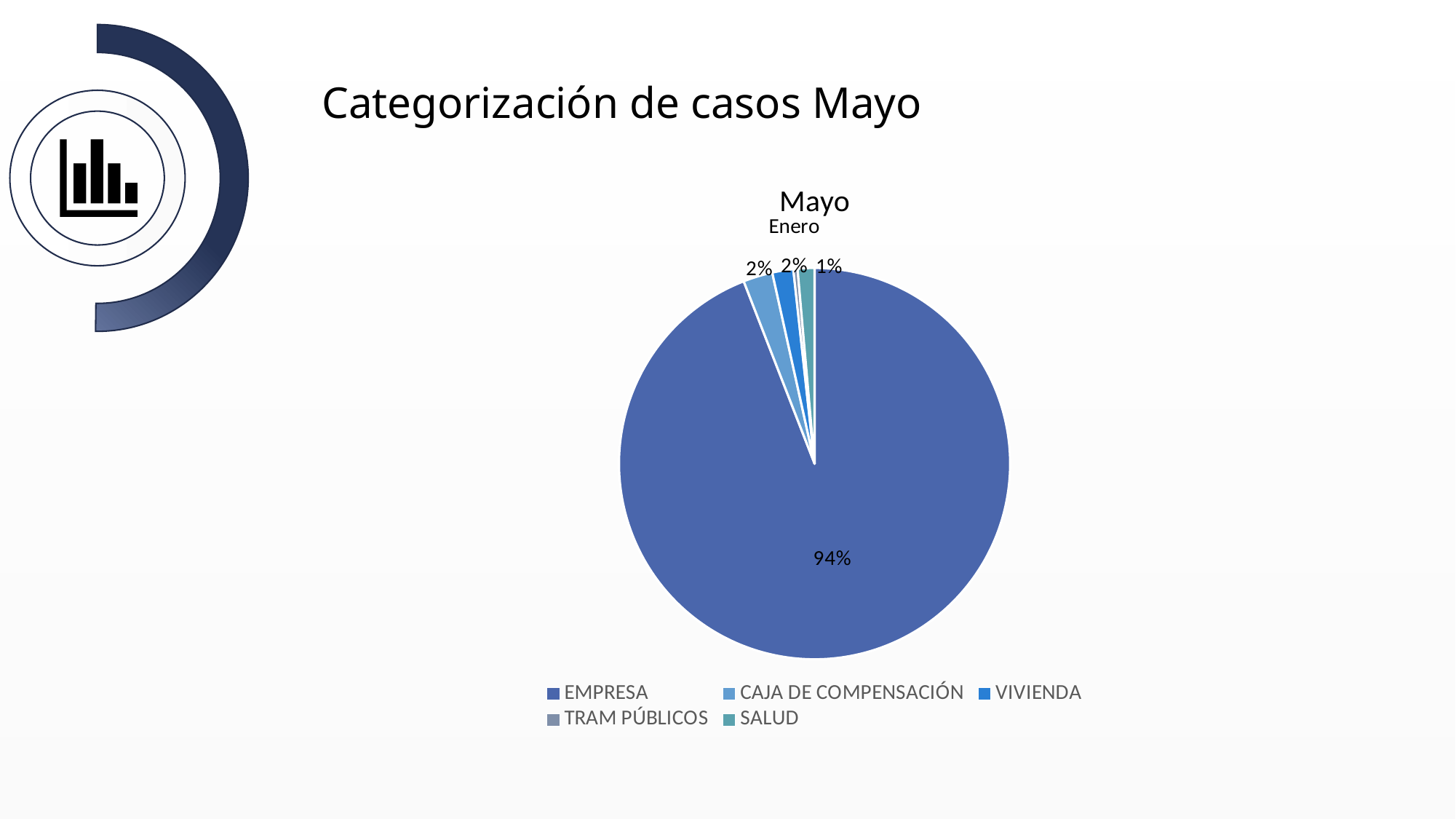
What is the title of the chart? Mayo What share of the pie does EMPRESA have? 94% How many categories does the legend list? 5 What kind of chart is shown on the slide? pie chart Which legend entry is listed first? EMPRESA What share of the pie does CAJA DE COMPENSACIÓN have? 2% Which category has the largest share of the pie? EMPRESA Which is larger, the share for EMPRESA or the share for VIVIENDA? EMPRESA Is the share for EMPRESA greater or less than 50%? greater What share of the pie does VIVIENDA have? 2% What is the difference in percentage points between the EMPRESA share and the SALUD share? 93